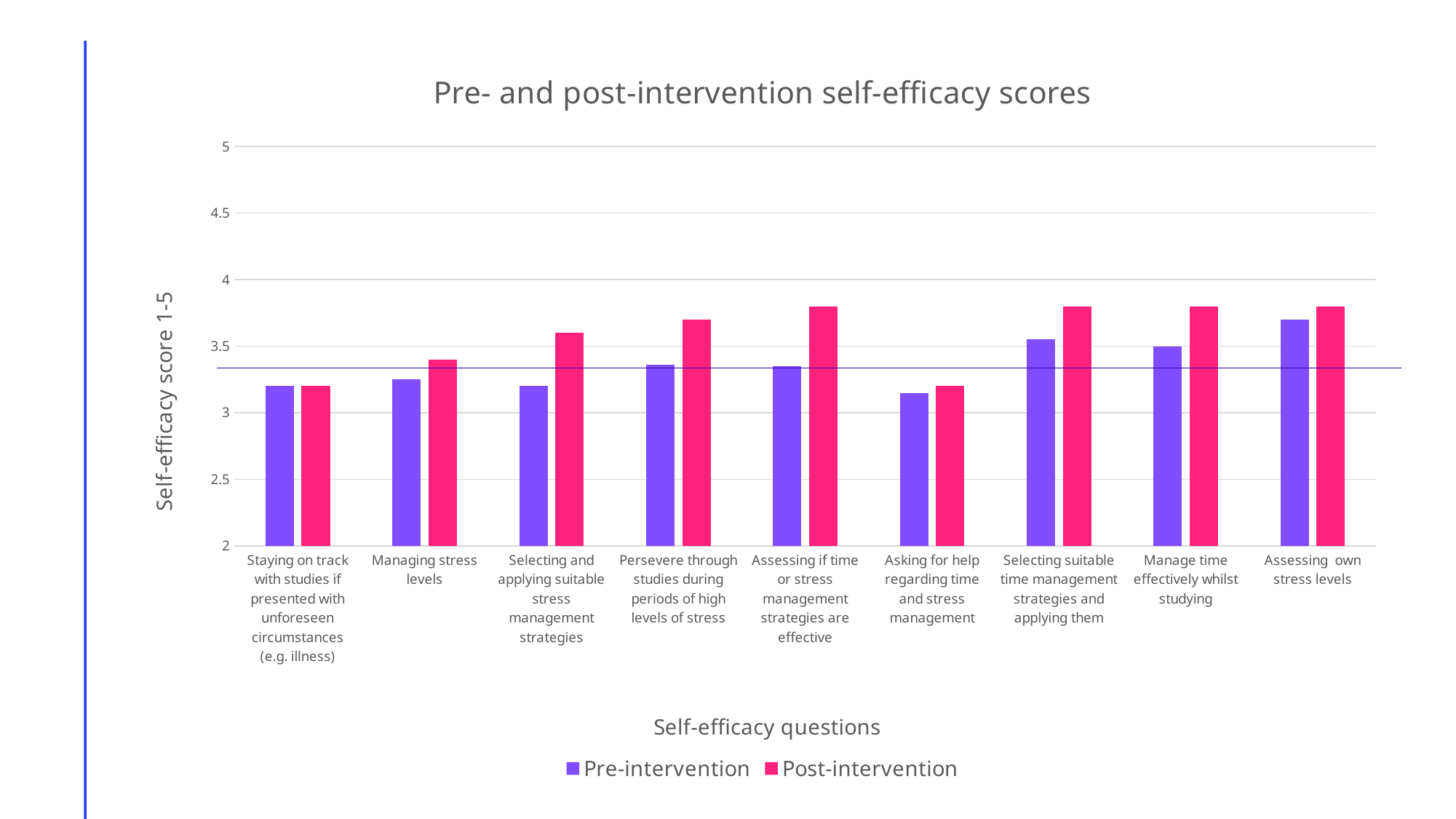
Which category has the highest Pre-intervention score? Assessing own stress levels Is the Post-intervention value for 'Assessing if time or stress management strategies are effective' greater or less than 4? less What is the label on the vertical axis? Self-efficacy score 1-5 Is the Pre-intervention value for 'Asking for help regarding time and stress management' greater or less than 3.5? less How many series does the legend list? 2 What is the title of the chart? Pre- and post-intervention self-efficacy scores Is the Post-intervention value for 'Managing stress levels' greater or less than 3.5? less For 'Persevere through studies during periods of high levels of stress', which is larger: the Pre-intervention or the Post-intervention score? Post-intervention What kind of chart is shown on the slide? Bar chart How many self-efficacy questions (categories) are shown on the x axis? 9